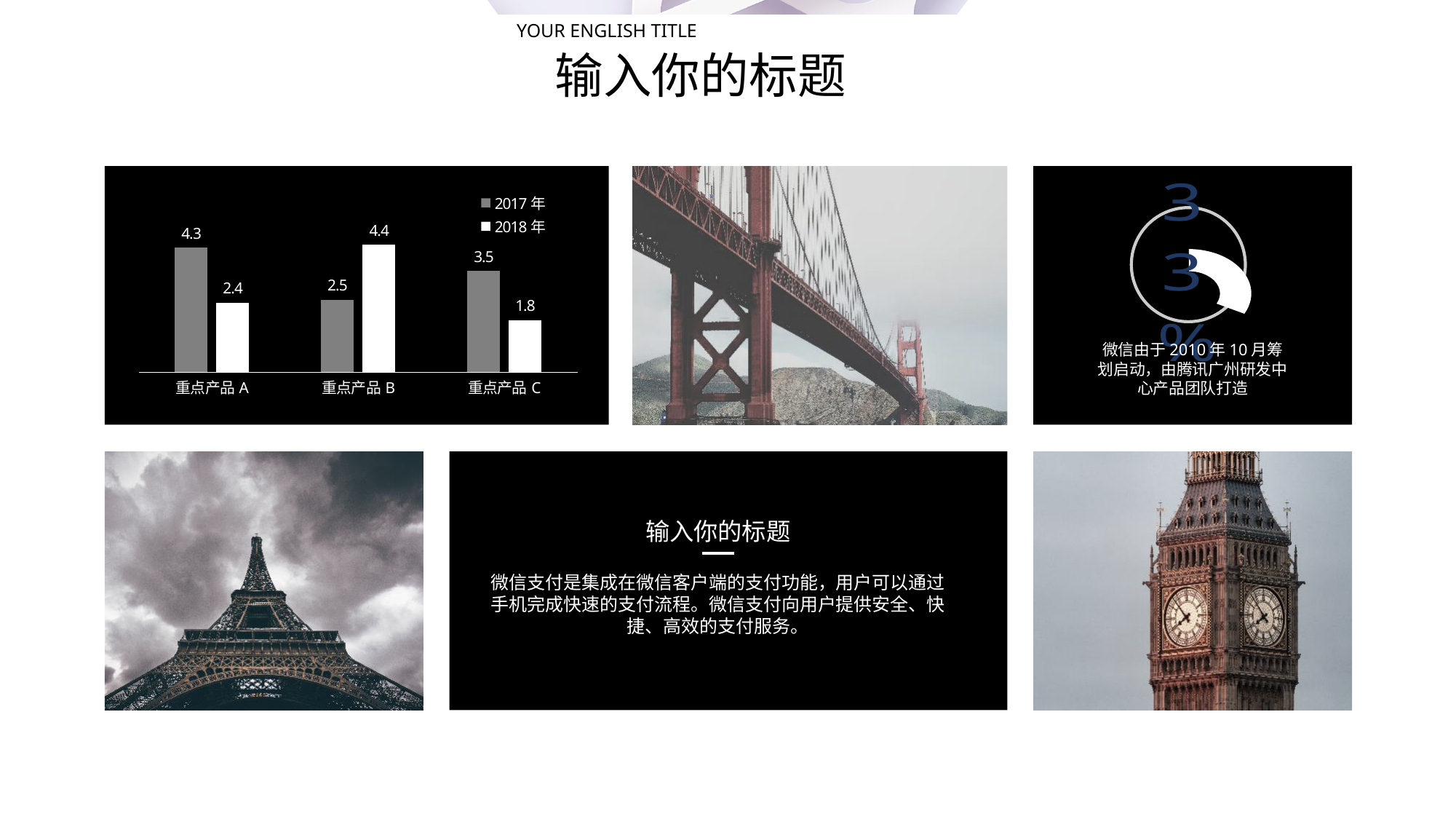
In the bar chart on the top left, which category has the highest 2018 年 value? 重点产品 B In the bar chart on the top left, what is the difference between the 2017 年 and 2018 年 values for 重点产品 A? 1.9 How many categories are shown in the bar chart on the top left? 3 In the bar chart on the top left, what is the 2018 年 value for 重点产品 B? 4.4 How many series does the legend of the bar chart on the top left list? 2 What type of chart is shown on the top left of the slide? Bar chart In the bar chart on the top left, what is the 2017 年 value for 重点产品 B? 2.5 In the bar chart on the top left, what is the 2018 年 value for 重点产品 C? 1.8 In the bar chart on the top left, which category has the lowest 2017 年 value? 重点产品 B In the bar chart on the top left, what is the 2017 年 value for 重点产品 A? 4.3 In the bar chart on the top left, which category has the lowest 2018 年 value? 重点产品 C In the bar chart on the top left, which is larger for 重点产品 C: the 2017 年 value or the 2018 年 value? 2017 年